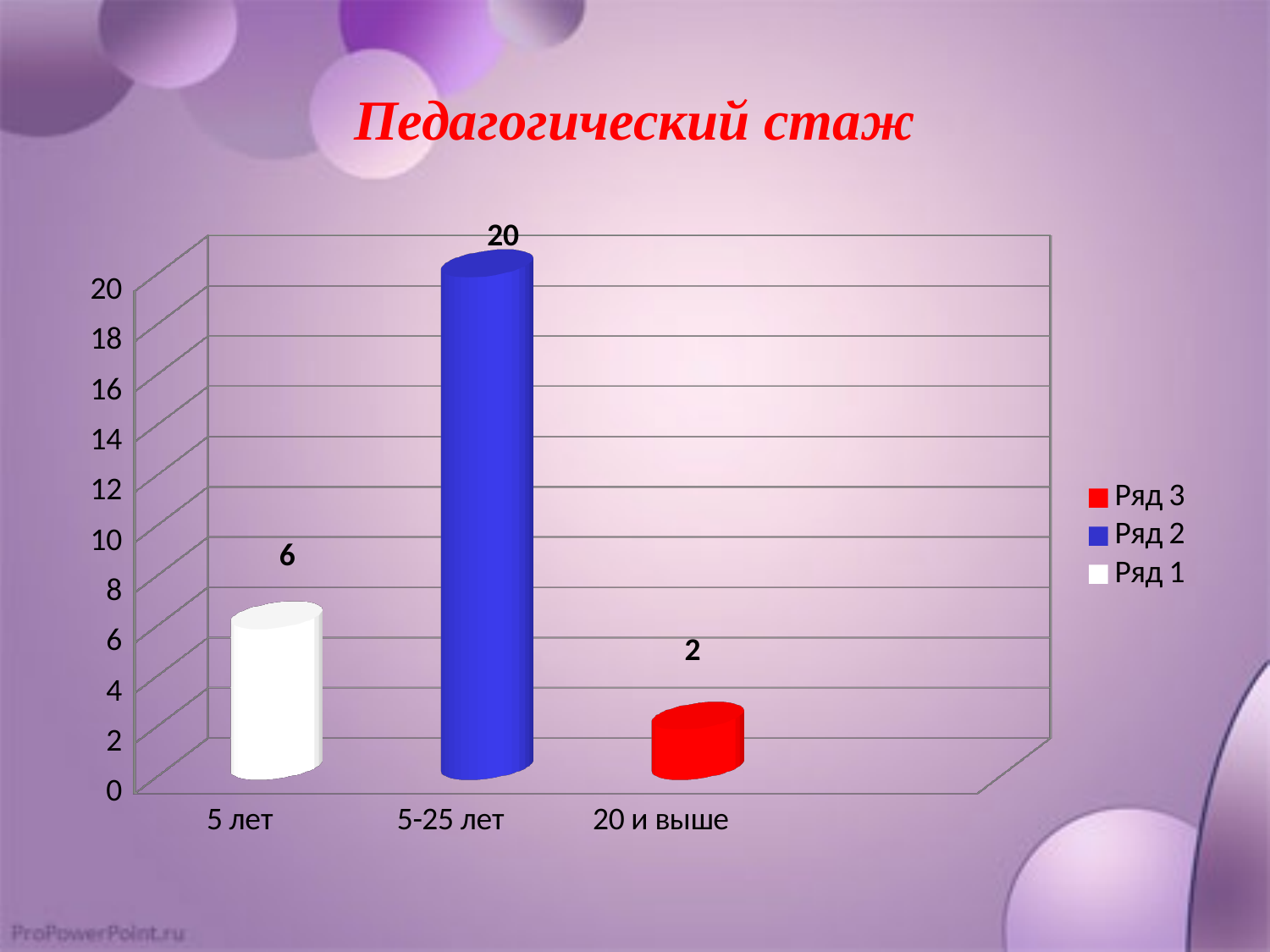
What is the value for the "5 лет" category? 6 What is the value for the "20 и выше" category? 2 How many series does the legend list? 3 What kind of chart is shown on the slide? bar chart Which is larger, the value for "5 лет" or the value for "20 и выше"? 5 лет What is the difference between the values for "5 лет" and "20 и выше"? 4 Which category has the lowest value? 20 и выше How many categories are shown on the x axis? 3 What is the value for the "5-25 лет" category? 20 What is the difference between the values for "5-25 лет" and "5 лет"? 14 Which category has the highest value? 5-25 лет Is the value for "5 лет" greater or less than 10? less